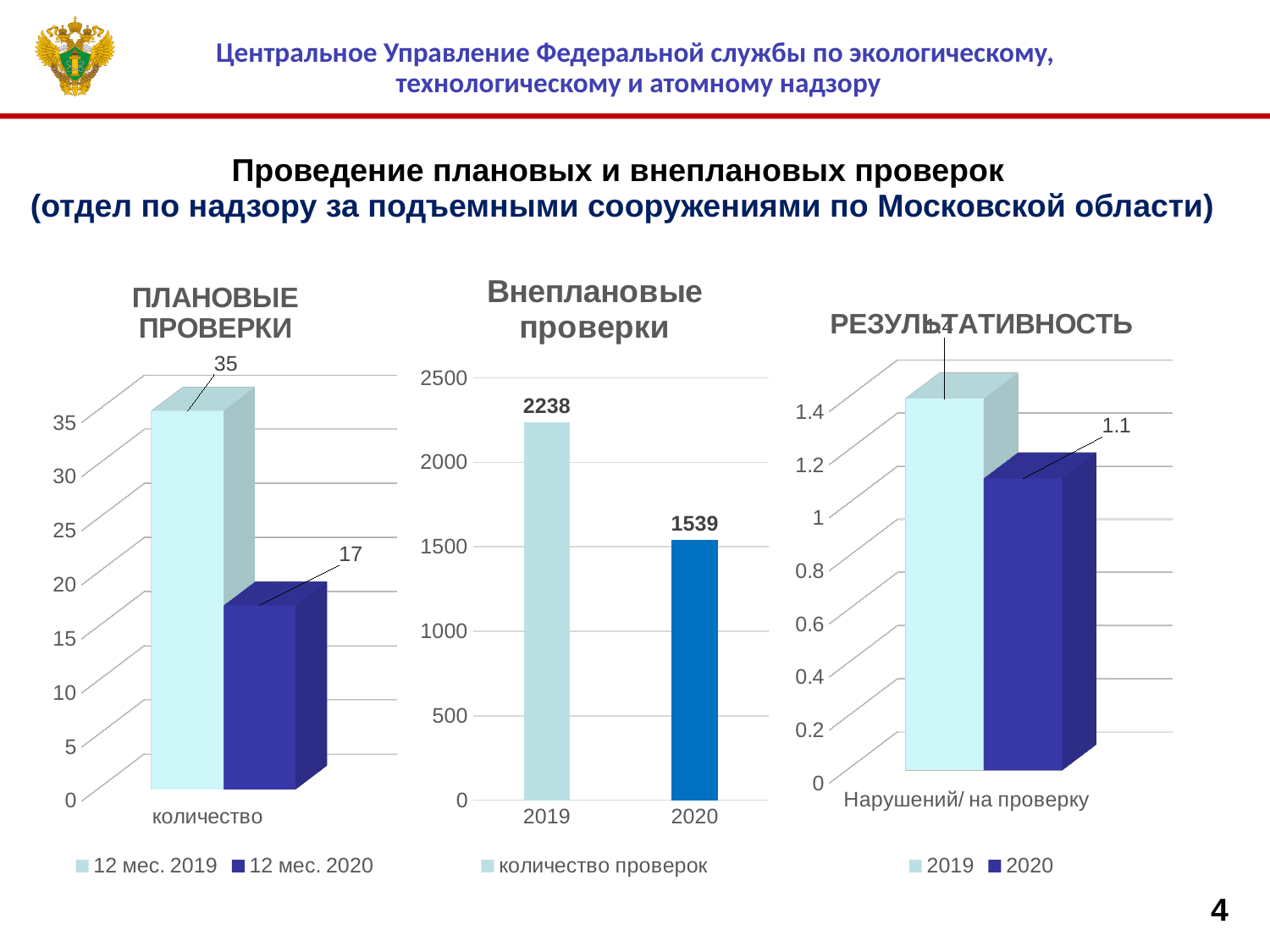
In the 'ПЛАНОВЫЕ ПРОВЕРКИ' chart, what is the difference between the 2019 and 2020 values? 18 How many series does the legend of the 'ПЛАНОВЫЕ ПРОВЕРКИ' chart list? 2 In the 'Внеплановые проверки' chart, which year has the higher value? 2019 What kind of chart is the 'Внеплановые проверки' chart? bar chart In the 'РЕЗУЛЬТАТИВНОСТЬ' chart, what is the value for 2020? 1.1 In the 'РЕЗУЛЬТАТИВНОСТЬ' chart, is the value for 2019 greater or less than 1.2? greater In the 'Внеплановые проверки' chart, what is the value for 2020? 1539 In the 'Внеплановые проверки' chart, what is the value for 2019? 2238 In the 'Внеплановые проверки' chart, what is the difference between the 2019 and 2020 values? 699 In the 'РЕЗУЛЬТАТИВНОСТЬ' chart, which year has the lower value? 2020 In the 'ПЛАНОВЫЕ ПРОВЕРКИ' chart, what is the value for 12 мес. 2019? 35 In the 'ПЛАНОВЫЕ ПРОВЕРКИ' chart, what is the value for 12 мес. 2020? 17